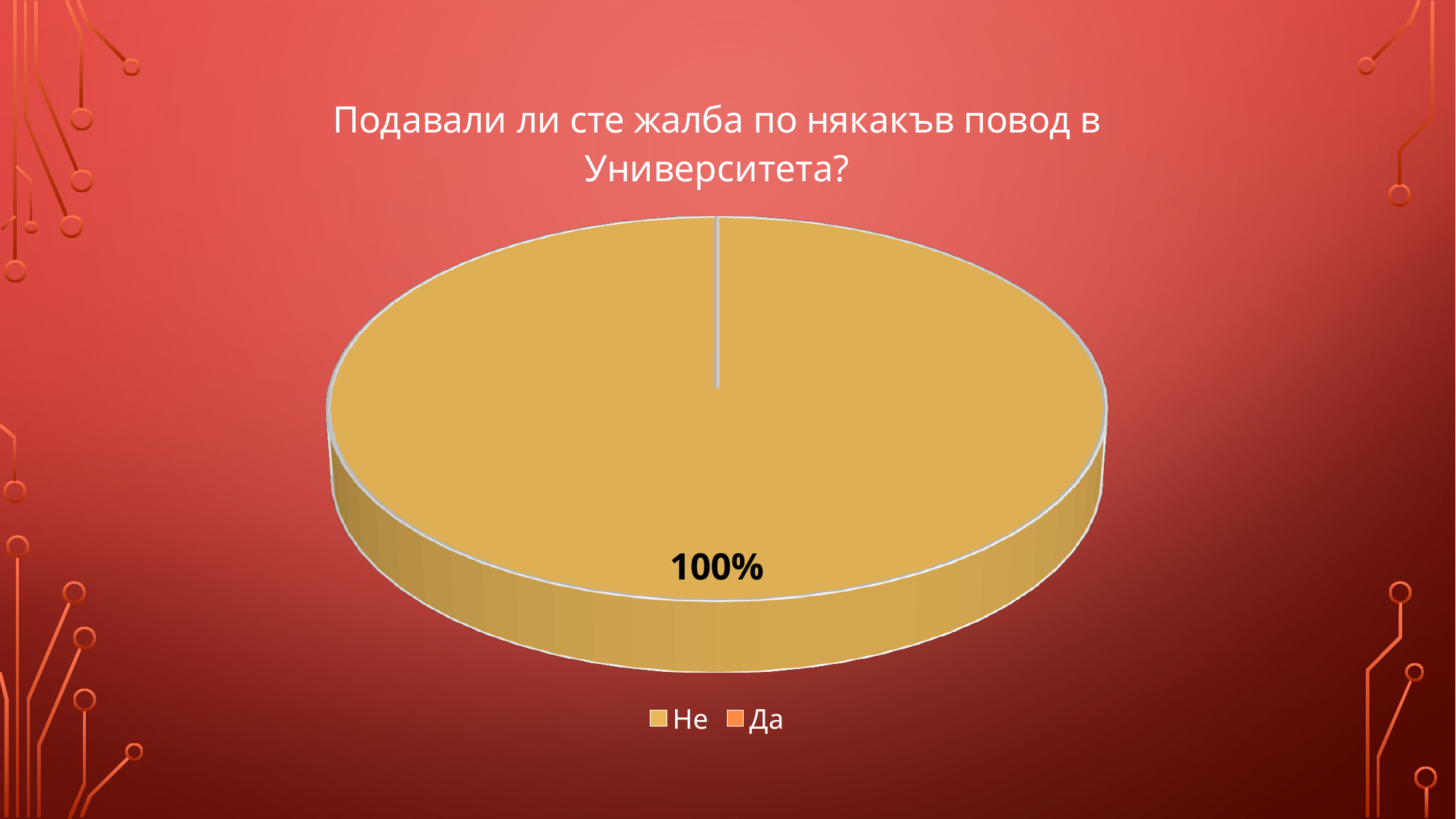
What is the title of the chart? Подавали ли сте жалба по някакъв повод в Университета? Which category has the smallest share of the pie? Да What percentage label is printed on the pie? 100% How many entries does the legend list? 2 What kind of chart is shown on the slide? pie chart What share of the pie does the "Не" slice take? 100% Which category has the largest share of the pie? Не Is the share for "Да" greater or less than 50%? less Is the share for "Не" greater or less than 50%? greater What colour is used for the "Не" category in the legend? gold Which category has the larger share, "Не" or "Да"? Не